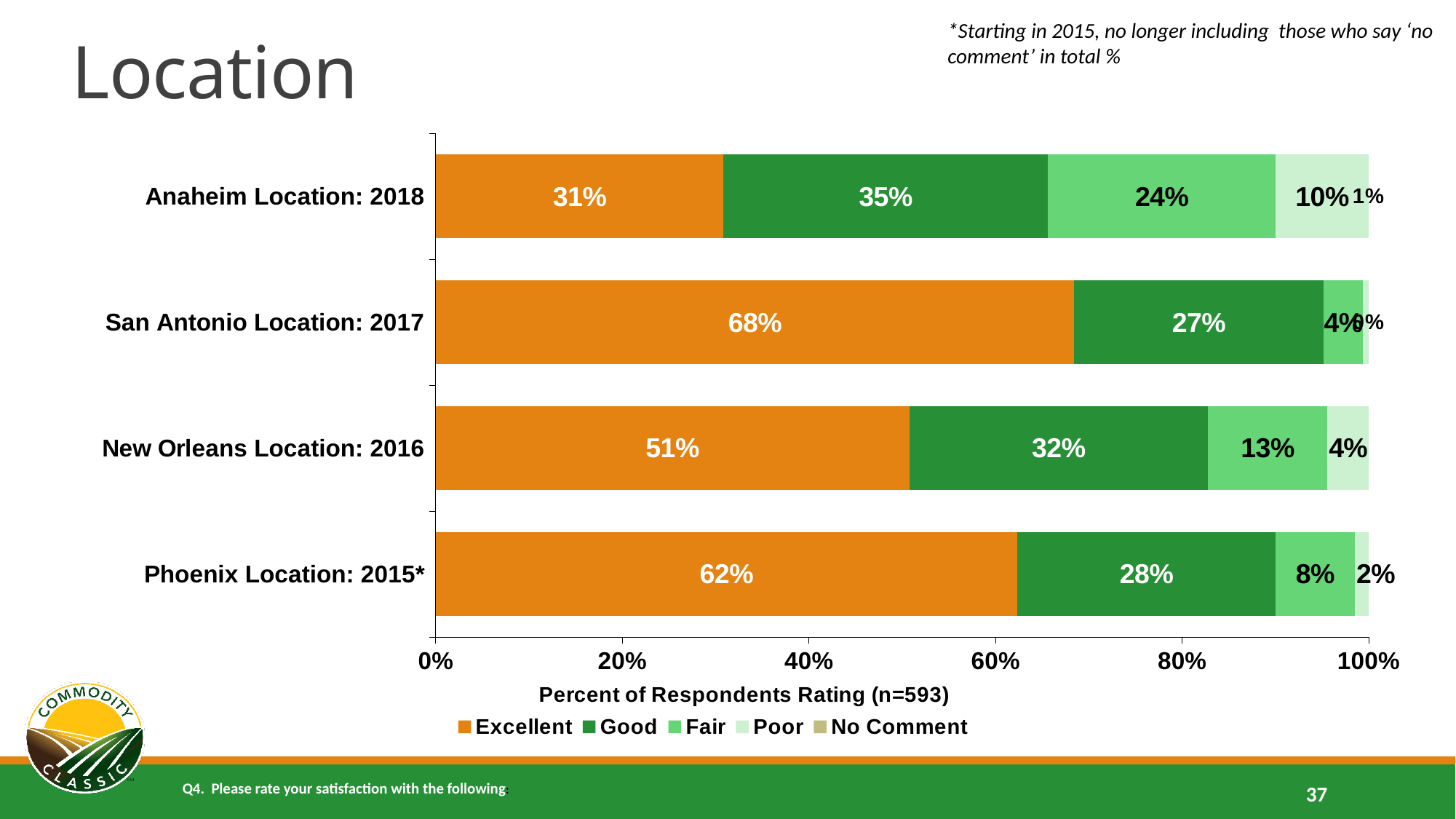
What percentage rated the Anaheim Location: 2018 as Excellent? 31% What percentage rated the New Orleans Location: 2016 as Fair? 13% What is the x-axis title of the chart? Percent of Respondents Rating (n=593) What percentage rated the San Antonio Location: 2017 as Excellent? 68% How many series does the legend list? 5 Which location has the lowest Excellent rating? Anaheim Location: 2018 How many location categories are plotted on the chart? 4 What type of chart is shown on the slide? Stacked bar chart Which is larger: the Good rating for Anaheim Location: 2018 or the Good rating for New Orleans Location: 2016? Anaheim Location: 2018 What percentage rated the Phoenix Location: 2015* as Good? 28% Which location has the highest Excellent rating? San Antonio Location: 2017 What is the difference between the Excellent ratings for San Antonio Location: 2017 and Anaheim Location: 2018? 37%